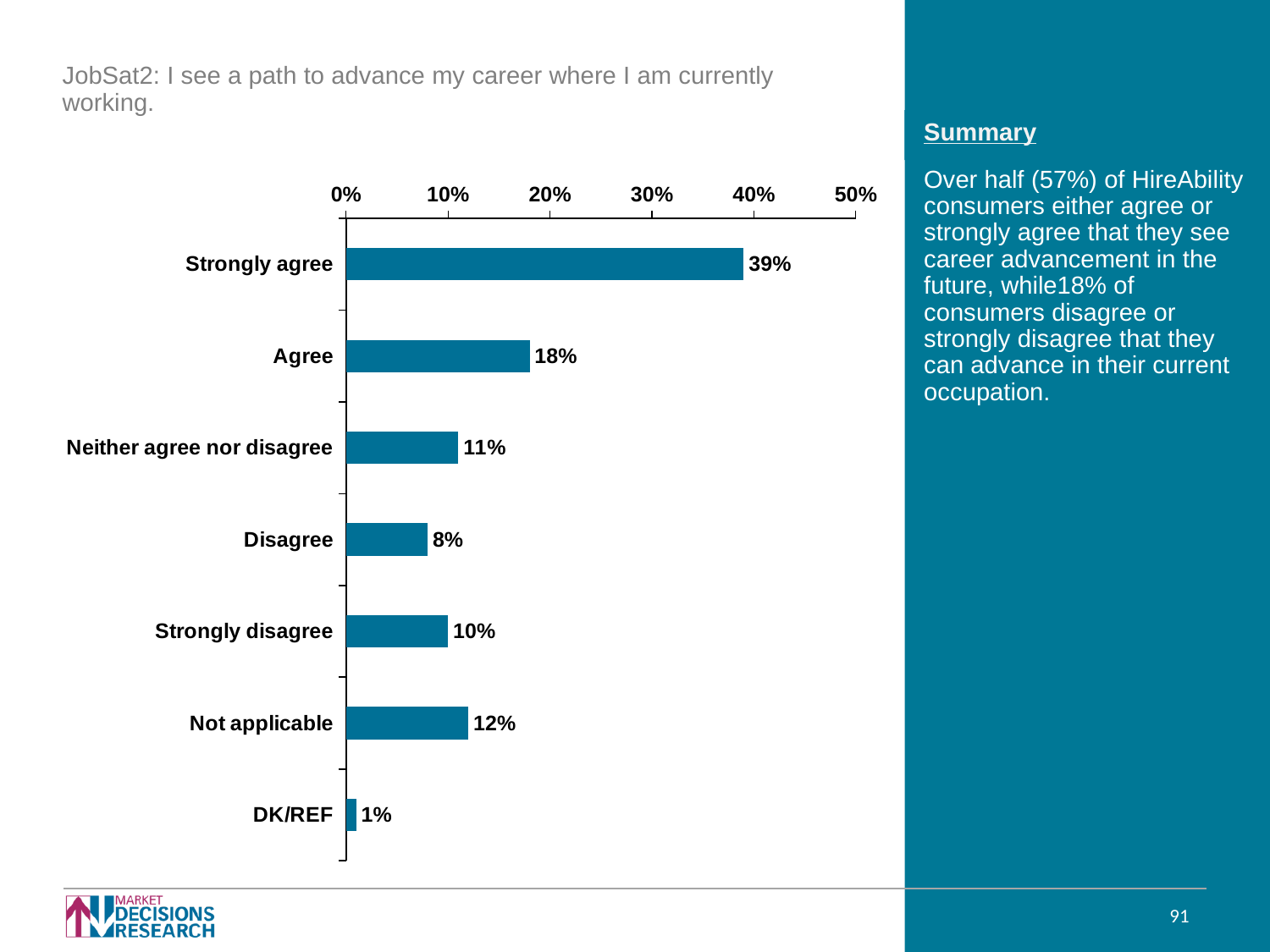
What is the maximum value shown on the percentage axis? 50% Which is larger, the value for 'Disagree' or the value for 'Strongly disagree'? Strongly disagree Which category has the highest value? Strongly agree What percentage of respondents answered 'Strongly agree'? 39% What is the difference between the 'Strongly agree' and 'Agree' values? 21% What is the difference between 'Not applicable' and 'Strongly disagree'? 2% How many categories are shown in the chart? 7 What percentage is shown for 'Not applicable'? 12% Is the value for 'Agree' greater or less than 20%? less What kind of chart is shown on the slide? Bar chart What is the value shown for 'Neither agree nor disagree'? 11% Which category has the lowest value? DK/REF